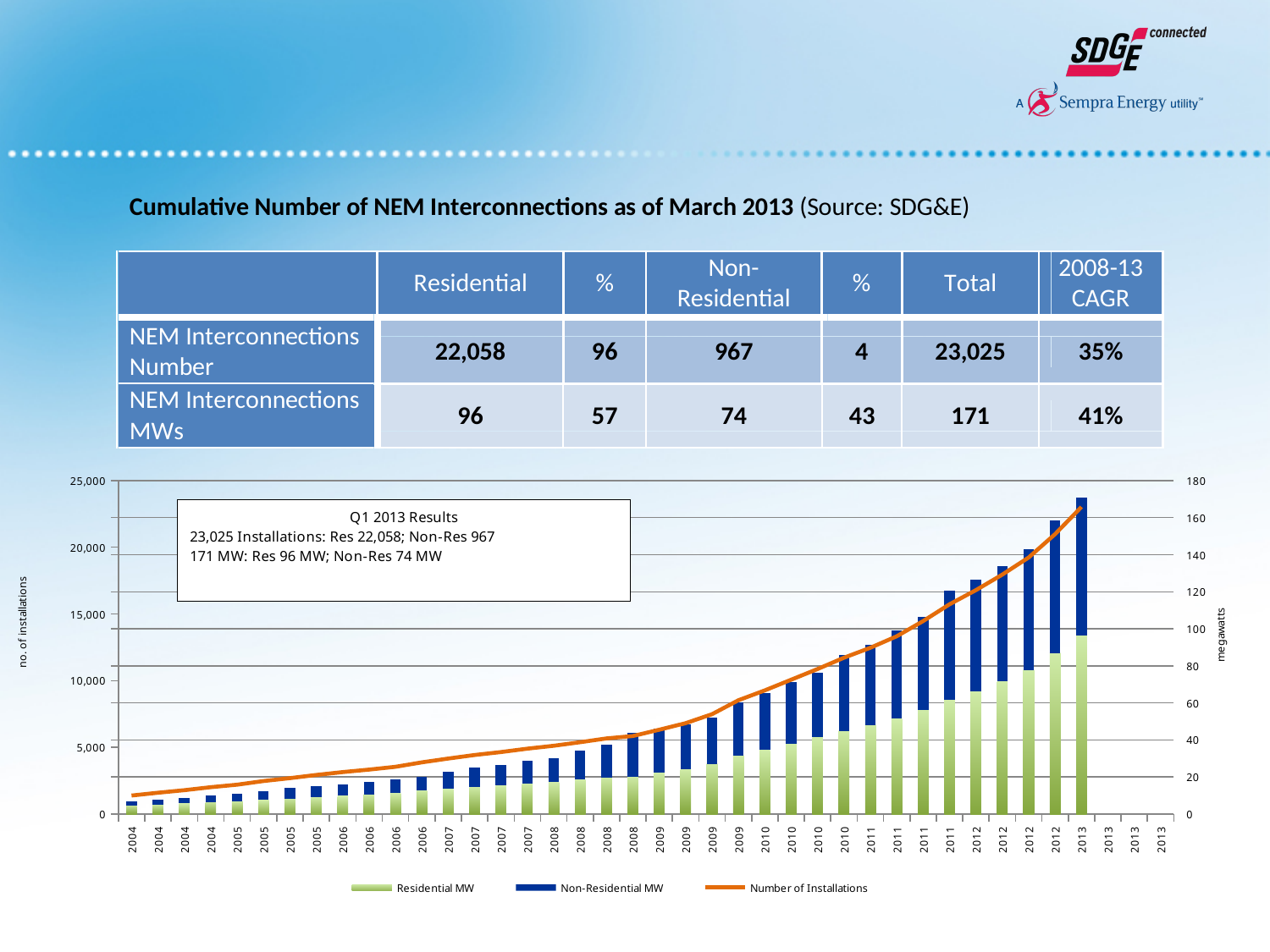
Does the Number of Installations line rise or fall from 2004 to 2013? Rise What is the label of the left vertical axis of the chart? no. of installations In Q1 2013, which is larger, residential MW or non-residential MW? Residential MW What kind of chart is shown on the slide? A stacked bar chart with a line What are the three series listed in the chart legend? Residential MW, Non-Residential MW, Number of Installations According to the annotation on the chart, what is the total number of installations in Q1 2013? 23,025 Is the Number of Installations value for 2013 greater or less than 20,000? greater According to the annotation on the chart, how many MW are non-residential in Q1 2013? 74 MW What is the total MW (residential plus non-residential) for Q1 2013 shown in the chart annotation? 171 MW How many series does the chart legend list? 3 Is the Residential MW value for the 2013 bar greater or less than 80? greater According to the annotation on the chart, how many MW are residential in Q1 2013? 96 MW